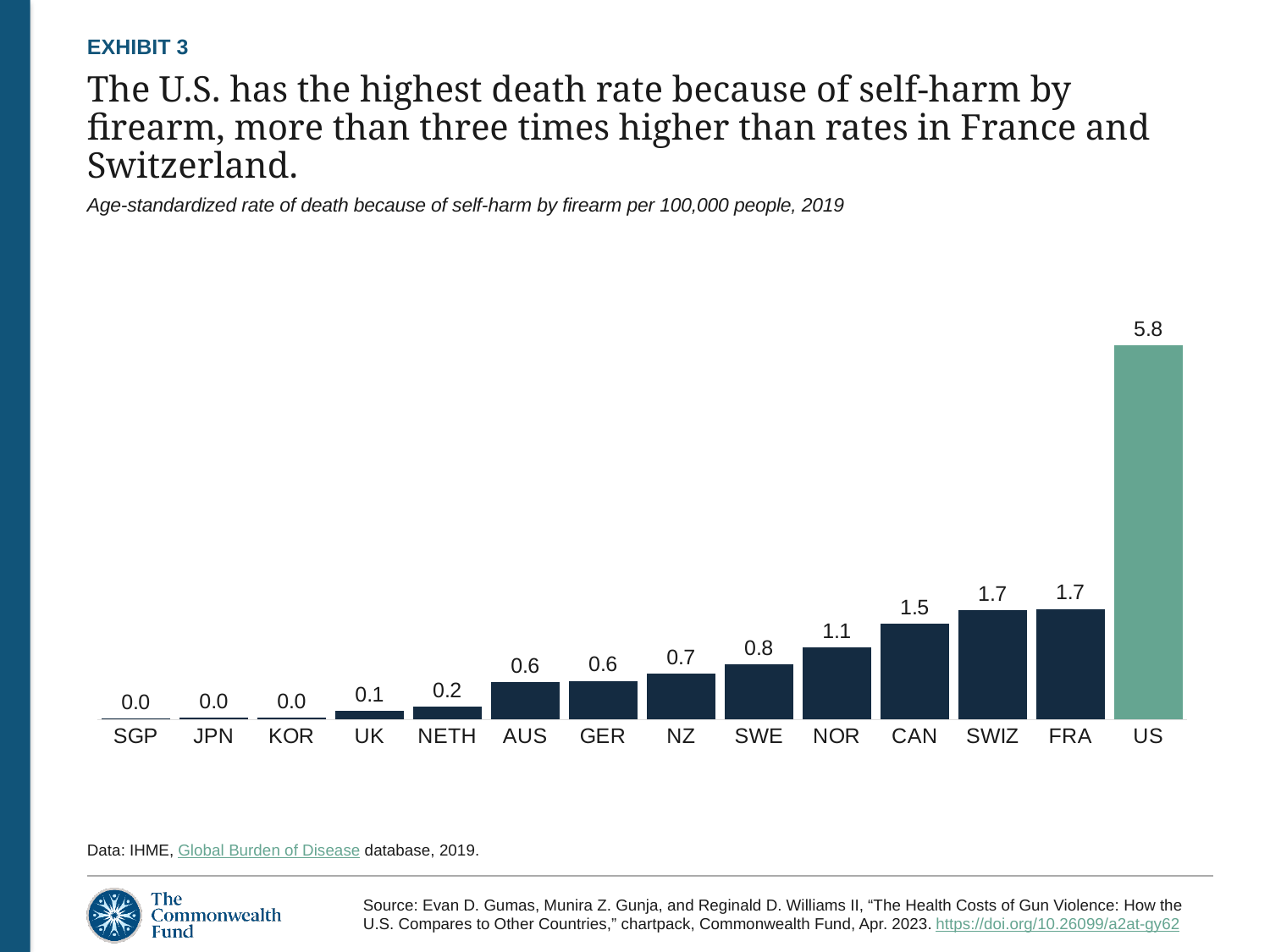
What kind of chart is shown on the slide? Bar chart Which bar is shown in a different colour (green) from the others? US What is the age-standardized rate of death because of self-harm by firearm per 100,000 people for the US? 5.8 Which has a higher value, AUS or SWE? SWE What is the value shown for CAN? 1.5 Do the values rise or fall moving from left to right along the x axis? Rise What is the value shown for NOR? 1.1 How many countries are shown on the chart? 14 Which has a higher value, CAN or NOR? CAN What is the difference between the values for the US and FRA? 4.1 What is the difference between the values for SWE and NZ? 0.1 Which country has the highest death rate because of self-harm by firearm on the chart? US